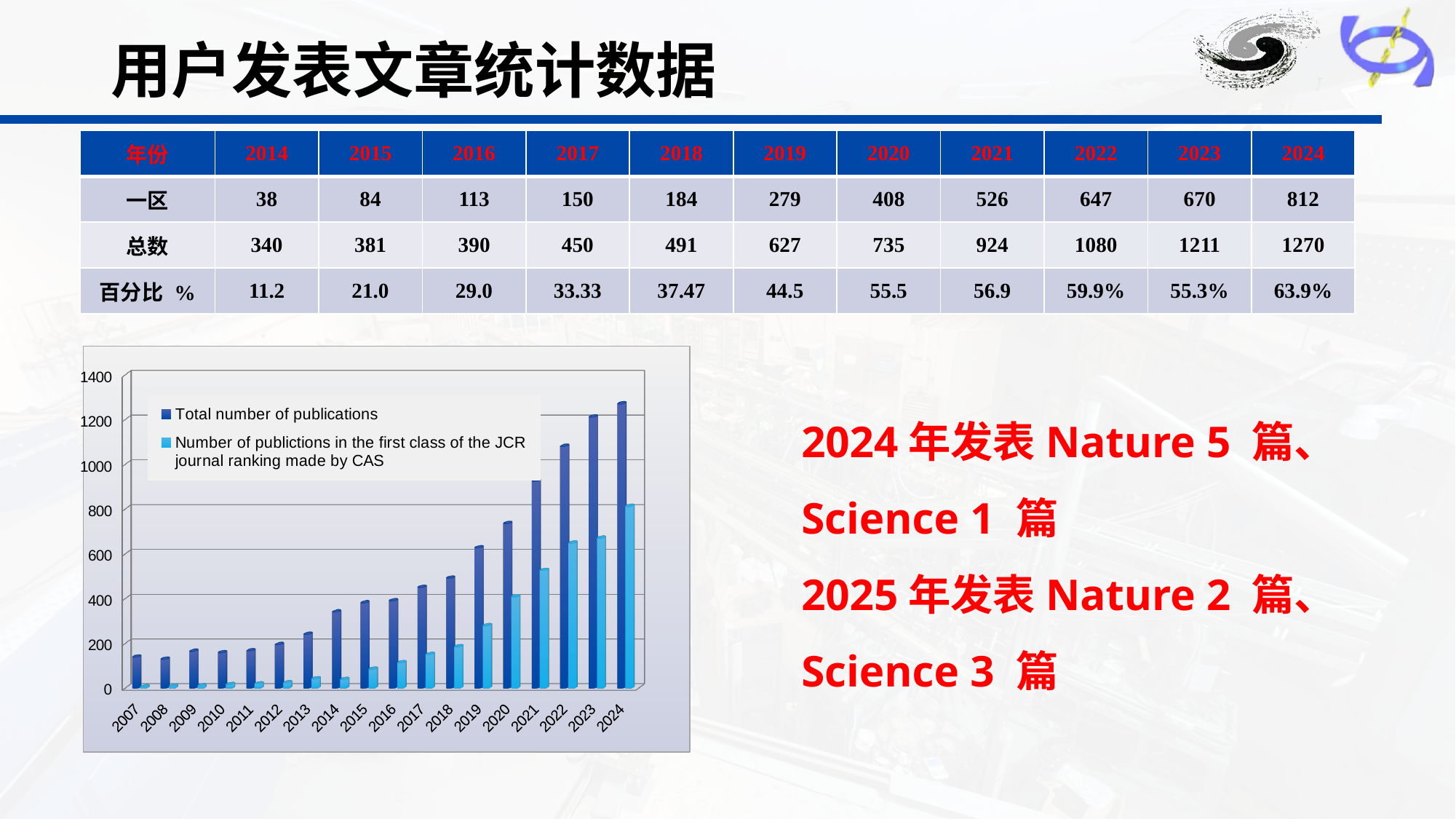
Which series is shown in dark blue in the chart's legend? Total number of publications What is the total number of publications for 2024? 1270 What is the number of first-class (JCR/CAS) publications for 2021? 526 How many years are shown along the x axis of the chart? 18 What is the difference between the total number of publications and the number of first-class publications in 2024? 458 Is the total number of publications for 2010 greater or less than 200? less How many series does the chart's legend list? 2 Is the number of first-class (JCR/CAS) publications for 2012 greater or less than 200? less Which year has the highest total number of publications in the chart? 2024 What kind of chart is shown on the slide? bar chart Do the total number of publications generally rise or fall from 2007 to 2024? rise Is the total number of publications for 2013 greater or less than 200? greater